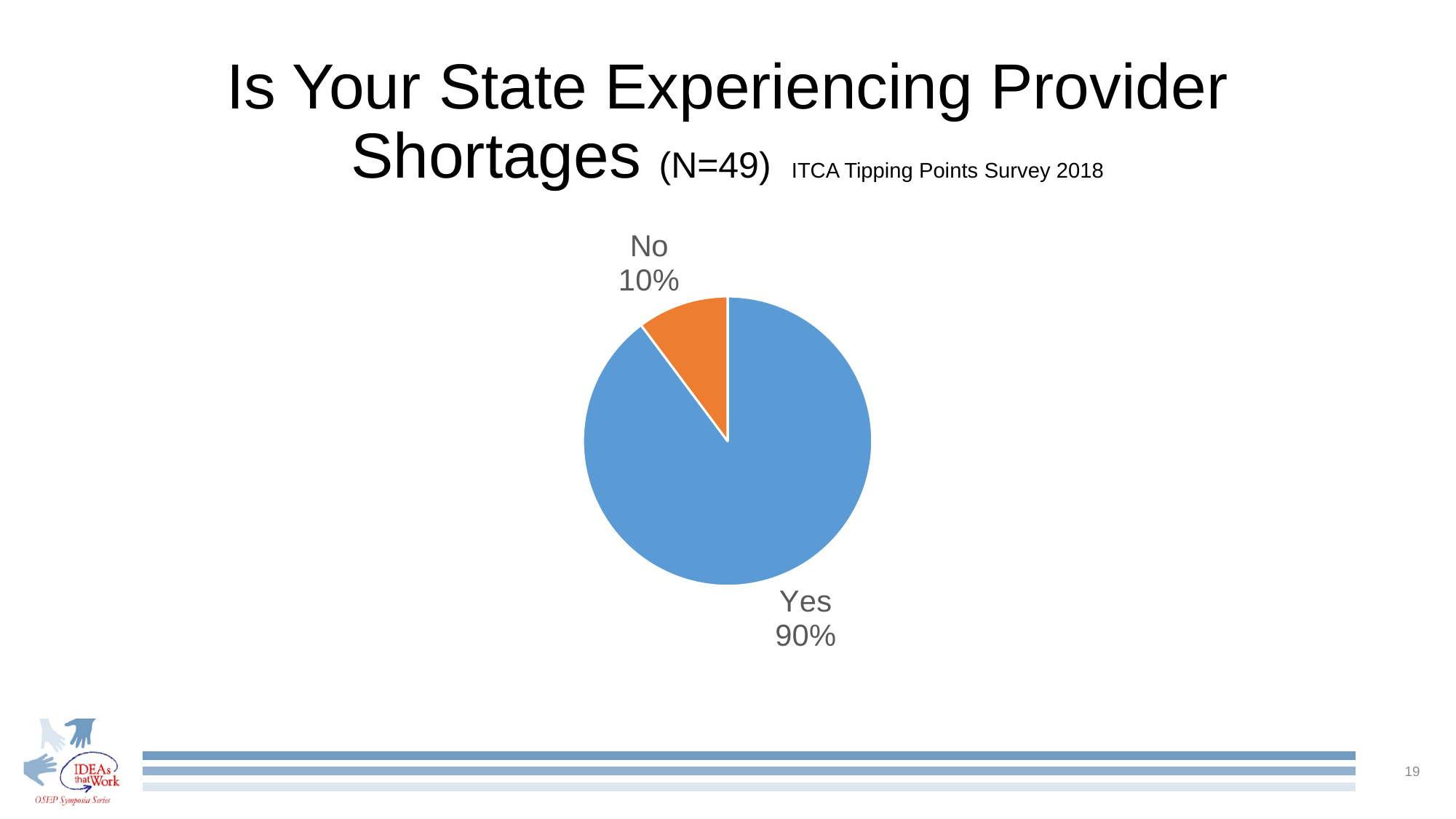
What percentage of states answered No to experiencing provider shortages? 10% What kind of chart is shown on the slide? pie chart What colour is the Yes slice of the pie chart? blue Which slice is larger, Yes or No? Yes How many slices does the pie chart have? 2 What percentage of states answered Yes to experiencing provider shortages? 90% What is the sample size (N) stated in the slide title? 49 Which response has the largest share of the pie? Yes What is the difference in percentage points between the Yes and No slices? 80 Which response has the smallest share of the pie? No What share of the pie does the No slice represent? 10%